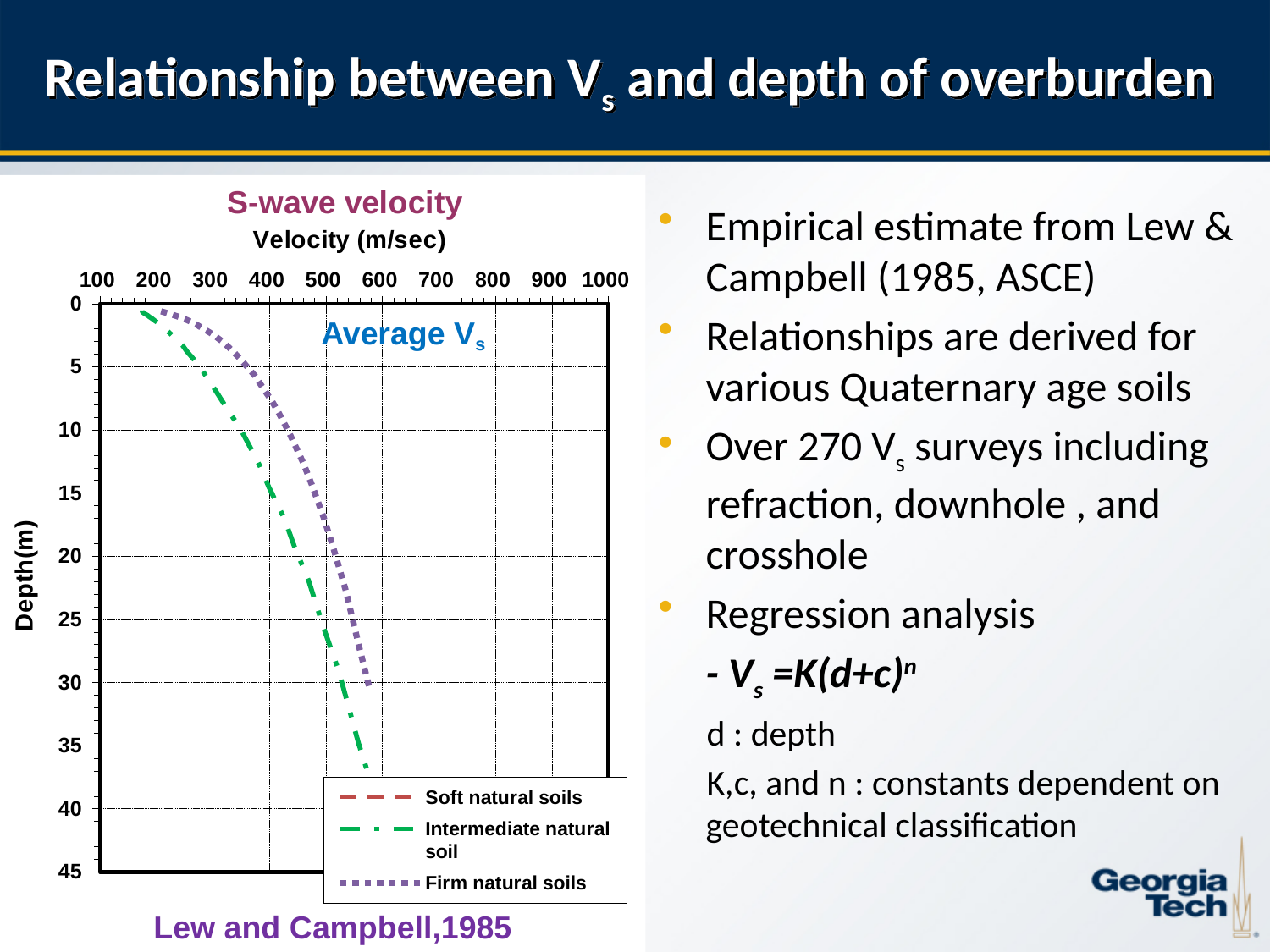
What is the title of the chart? S-wave velocity Is the velocity for Firm natural soils at a depth of 30 m greater or less than 500? greater At a depth of 20 m, which series has the higher velocity, Firm natural soils or Intermediate natural soil? Firm natural soils Is the velocity for Firm natural soils at a depth of 10 m greater or less than 400? greater Is the velocity for Intermediate natural soil at a depth of 20 m greater or less than 500? less Does the velocity for Intermediate natural soil increase or decrease as depth increases? increase What kind of chart is shown on the slide? line chart How many series does the chart legend list? 3 What is the label of the horizontal axis of the chart? Velocity (m/sec) Does the velocity for Firm natural soils increase or decrease as depth increases? increase